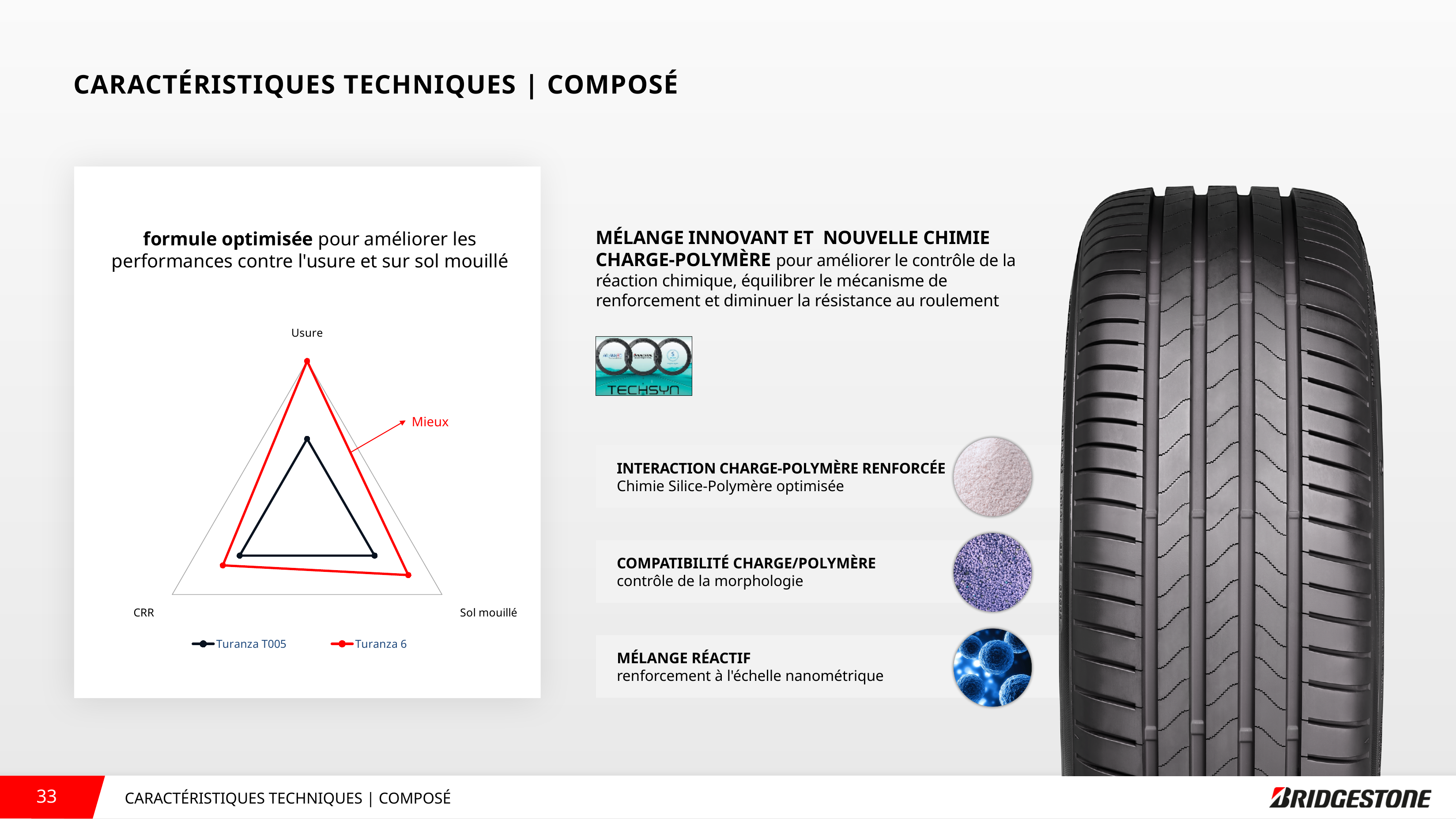
Which series has the larger value on the Usure axis, Turanza T005 or Turanza 6? Turanza 6 What colour is the line for the Turanza 6 series? Red Which series has the larger value on the CRR axis, Turanza T005 or Turanza 6? Turanza 6 Which series has the larger value on the Sol mouillé axis, Turanza T005 or Turanza 6? Turanza 6 What are the three axis labels of the radar chart? Usure, CRR, Sol mouillé How many series does the chart legend list? 2 How many axes (categories) does the radar chart have? 3 What are the names of the two series in the chart legend? Turanza T005 and Turanza 6 What kind of chart is shown on the slide? Radar chart